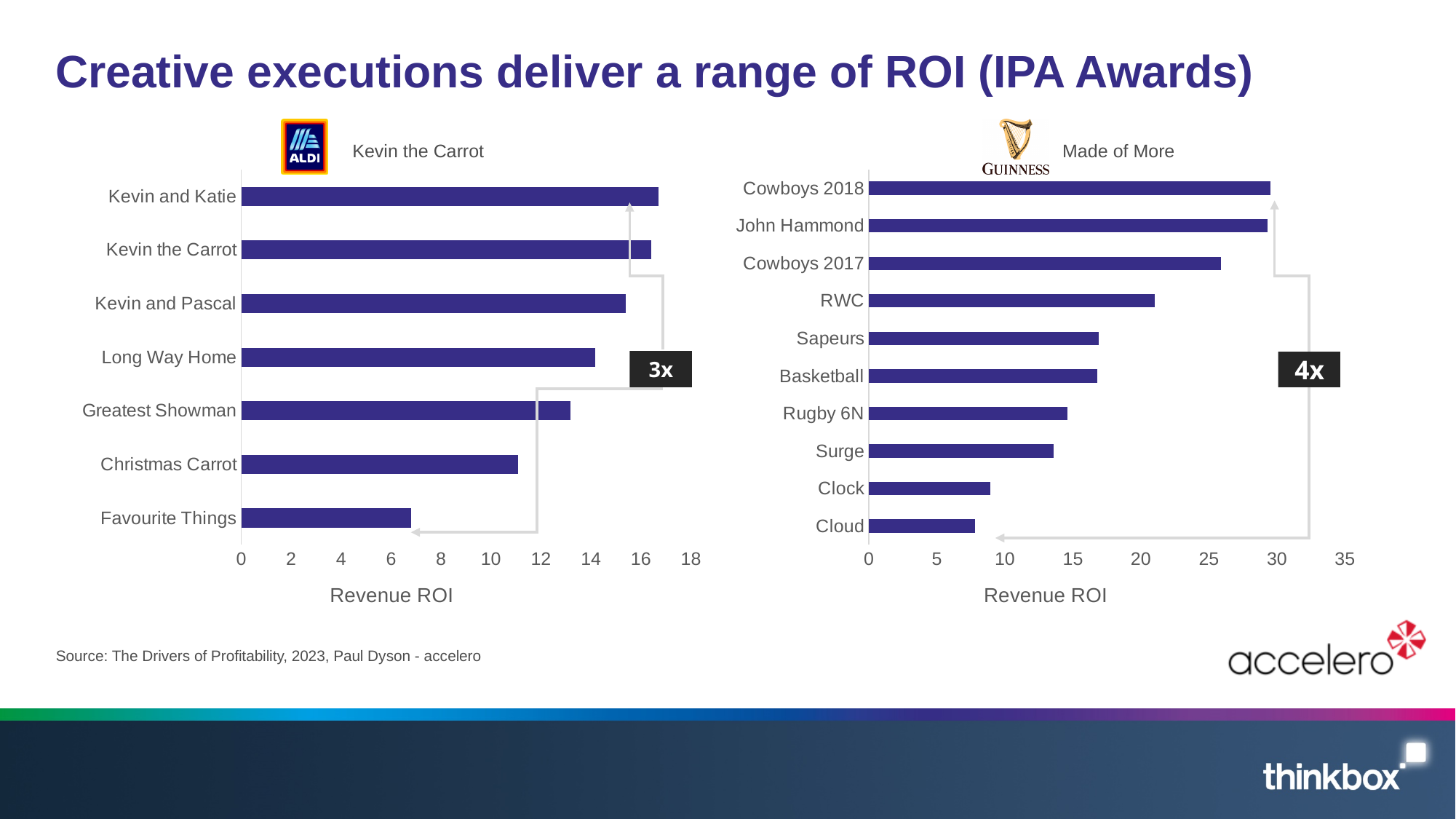
In the Made of More chart, which has the higher Revenue ROI: RWC or Sapeurs? RWC In the Made of More chart, is the Revenue ROI for Surge greater or less than 15? less In the Kevin the Carrot chart, is the Revenue ROI for Favourite Things greater or less than 8? less In the Kevin the Carrot chart, which execution has the lowest Revenue ROI? Favourite Things In the Made of More chart, how many creative executions are plotted? 10 In the Made of More chart, which execution has the lowest Revenue ROI? Cloud What kind of chart is the Kevin the Carrot chart on the left? bar chart In the Kevin the Carrot chart, is the Revenue ROI for Christmas Carrot greater or less than 10? greater What is the x-axis label on the Made of More chart? Revenue ROI In the Kevin the Carrot chart, how many creative executions are plotted? 7 In the Kevin the Carrot chart, which has the higher Revenue ROI: Kevin and Pascal or Long Way Home? Kevin and Pascal